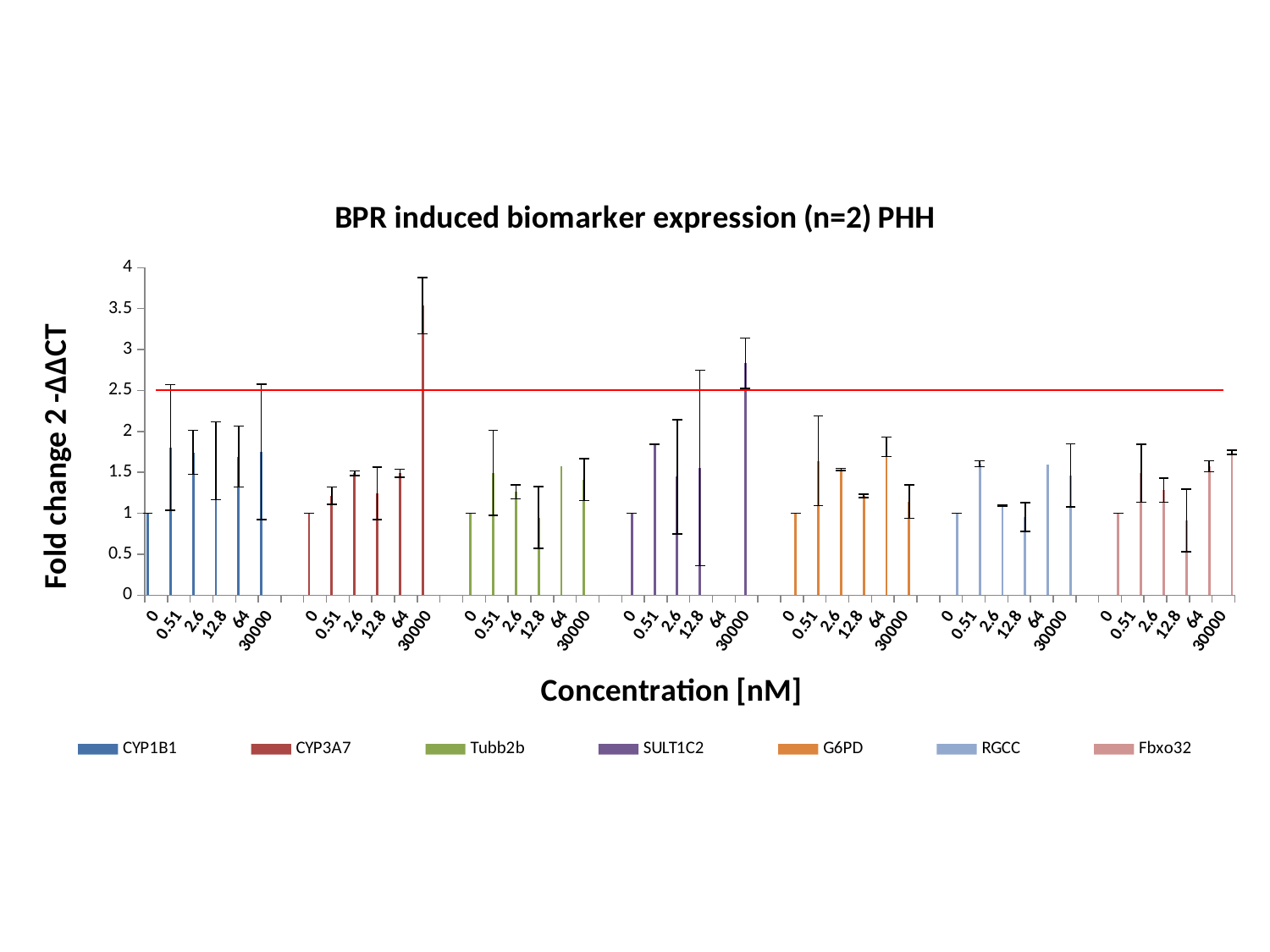
How many series does the legend list? 7 At which concentration does CYP3A7 reach its highest value? 30000 Is the value for CYP3A7 at 30000 nM greater or less than 3? greater Which series has the tallest bar in the chart? CYP3A7 Is the value for SULT1C2 at 30000 nM greater or less than 2? greater What is the title of the chart? BPR induced biomarker expression (n=2) PHH What is the label of the x axis? Concentration [nM] What kind of chart is shown on the slide? bar chart Is the value for G6PD at 64 nM greater or less than 1.5? greater How many concentration levels are plotted for each series? 6